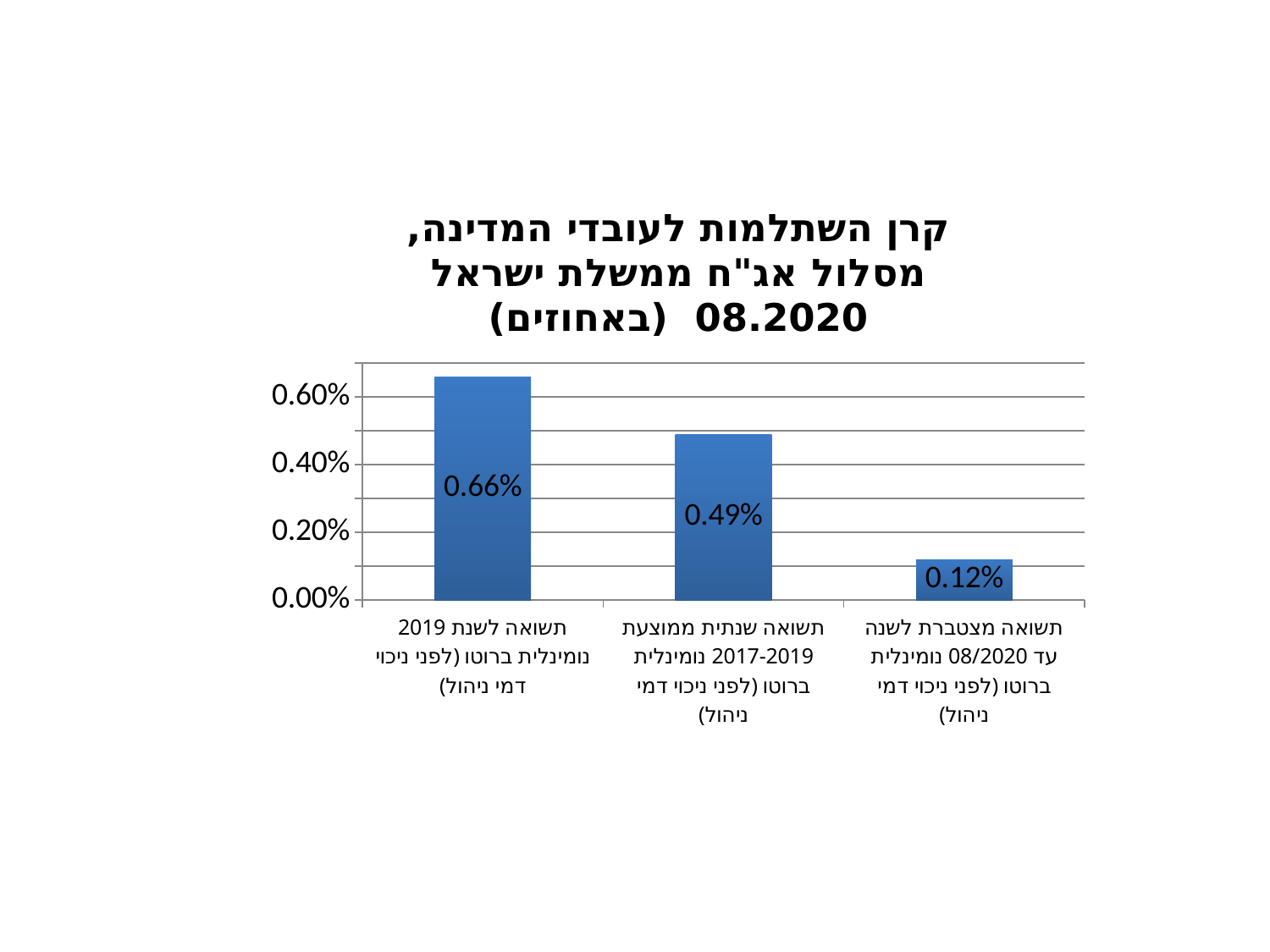
What is the value of the bar labelled "תשואה שנתית ממוצעת 2017-2019 נומינלית ברוטו" (average annual return 2017-2019)? 0.49% Is the value for the average annual return 2017-2019 greater or less than 0.40%? greater What is the difference between the 2019 return (0.66%) and the average annual return 2017-2019 (0.49%)? 0.17% Which category has the lowest value in the chart? תשואה מצטברת לשנה עד 08/2020 נומינלית ברוטו (לפני ניכוי דמי ניהול) What is the difference between the average annual return 2017-2019 and the cumulative return to 08/2020? 0.37% What is the value of the bar labelled "תשואה מצטברת לשנה עד 08/2020" (cumulative return for the year to 08/2020)? 0.12% What type of chart is shown on the slide? Bar chart How many bars are shown in the chart? 3 Which category has the highest value in the chart? תשואה לשנת 2019 נומינלית ברוטו (לפני ניכוי דמי ניהול) Which is larger: the 2019 return or the cumulative return to 08/2020? The 2019 return (0.66%) What is the value of the bar labelled "תשואה לשנת 2019 נומינלית ברוטו (לפני ניכוי דמי ניהול)" (2019 nominal gross return)? 0.66% Do the bar values rise or fall from left to right across the chart? Fall